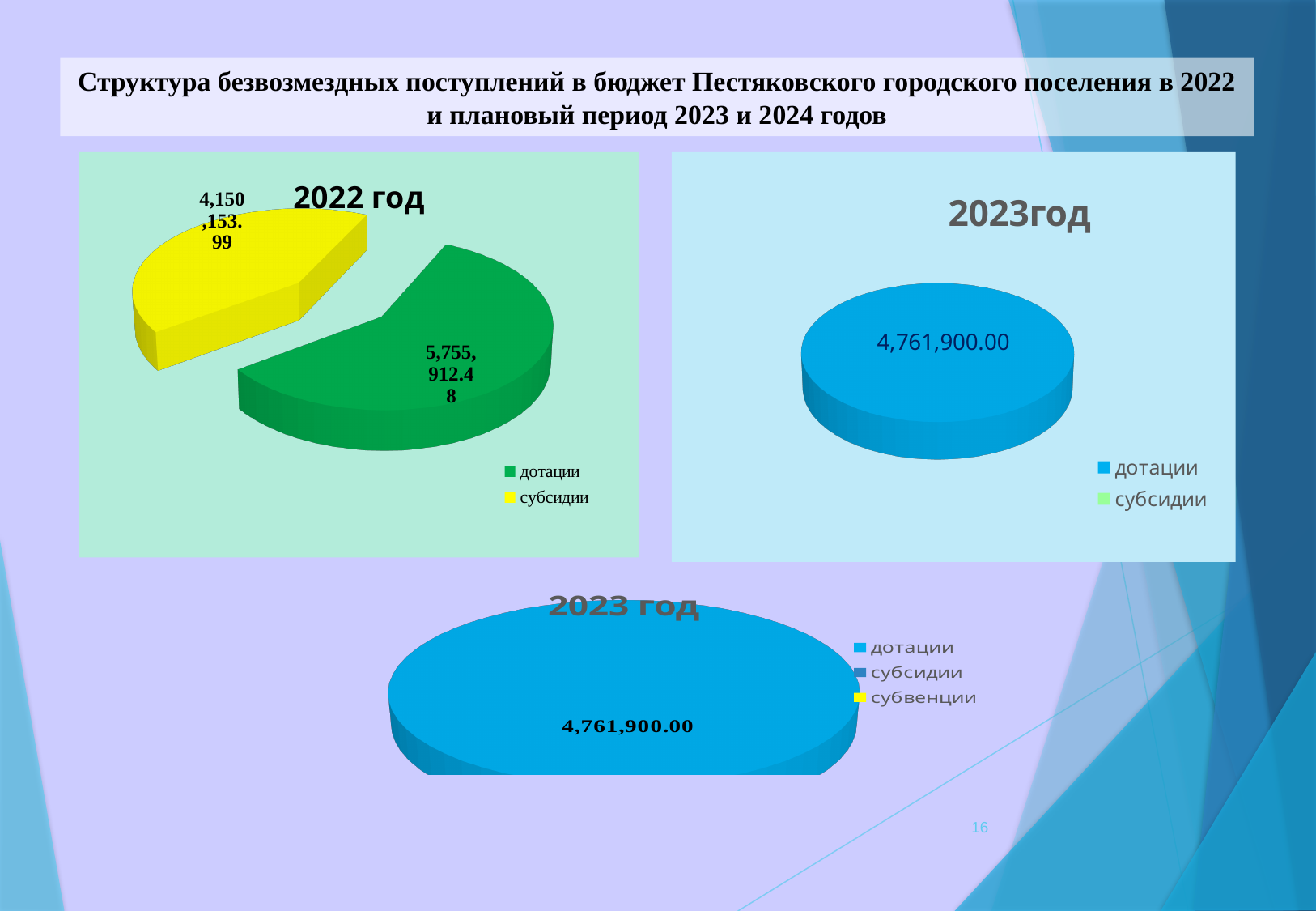
In the "2022 год" chart, what is the difference between дотации and субсидии? 1,605,758.49 What kind of chart is the "2022 год" chart on the top left? pie chart In the bottom "2023 год" chart, what value is printed on the pie? 4,761,900.00 In the "2022 год" chart, what is the total of дотации and субсидии? 9,906,066.47 How many entries does the legend of the "2023год" chart on the top right list? 2 In the "2022 год" chart, which category has the largest slice? дотации In the "2022 год" chart, what colour represents субсидии? yellow In the "2022 год" chart, what is the value for дотации? 5,755,912.48 In the "2022 год" chart, what is the value for субсидии? 4,150,153.99 In the "2023год" chart on the top right, what value is shown on the pie? 4,761,900.00 How many entries does the legend of the bottom "2023 год" chart list? 3 In the "2022 год" chart, which is larger: дотации or субсидии? дотации